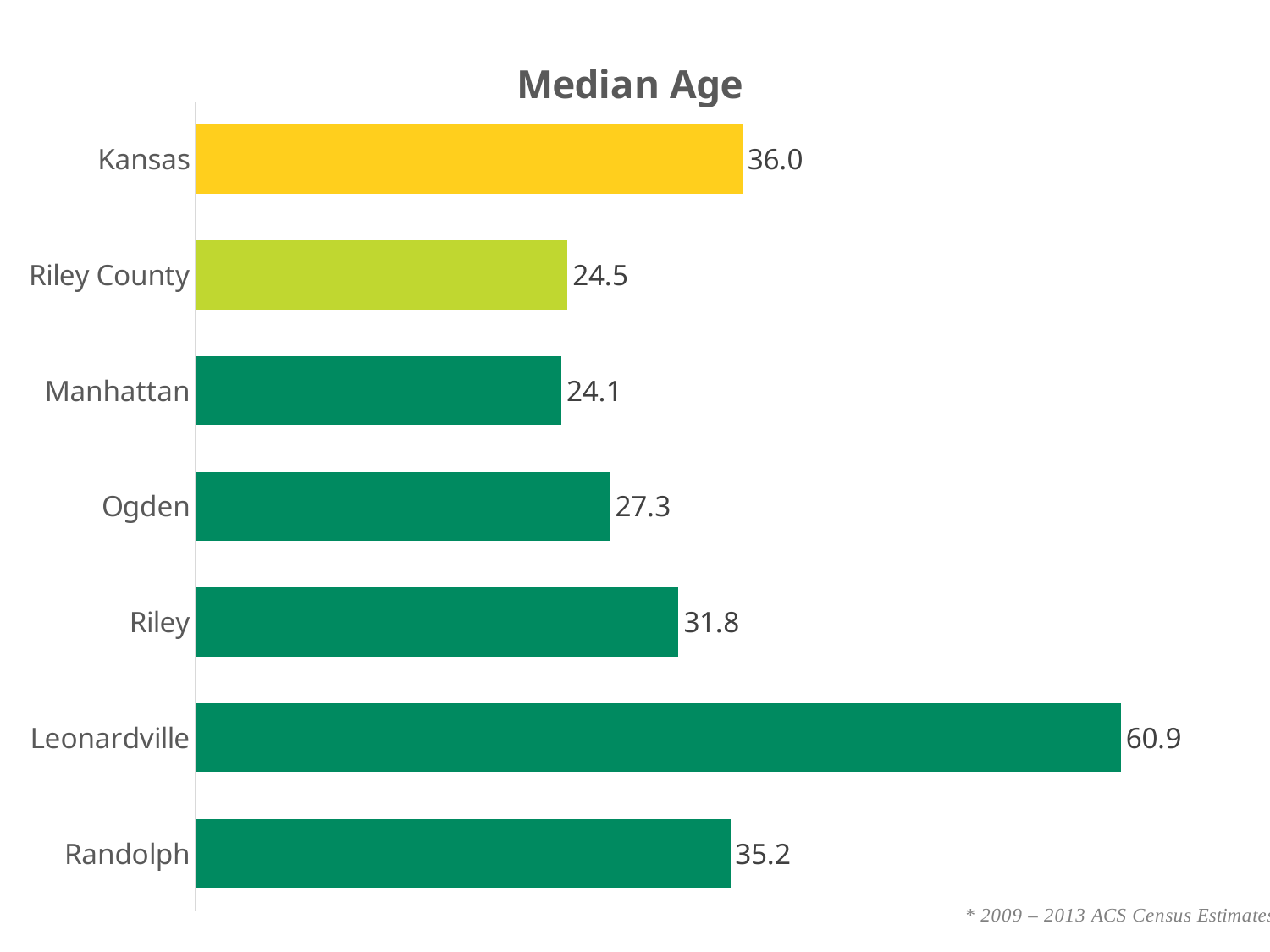
What is the difference between the median age of Riley and Ogden? 4.5 Which has a higher median age, Randolph or Riley? Randolph What is the median age shown for Kansas? 36.0 Which category has the lowest median age? Manhattan What is the median age shown for Manhattan? 24.1 What is the median age shown for Leonardville? 60.9 What is the title of the chart? Median Age Which category has the highest median age? Leonardville How many categories are shown in the chart? 7 What kind of chart is shown on the slide? Bar chart What is the difference between the median age of Leonardville and Kansas? 24.9 What is the median age shown for Ogden? 27.3